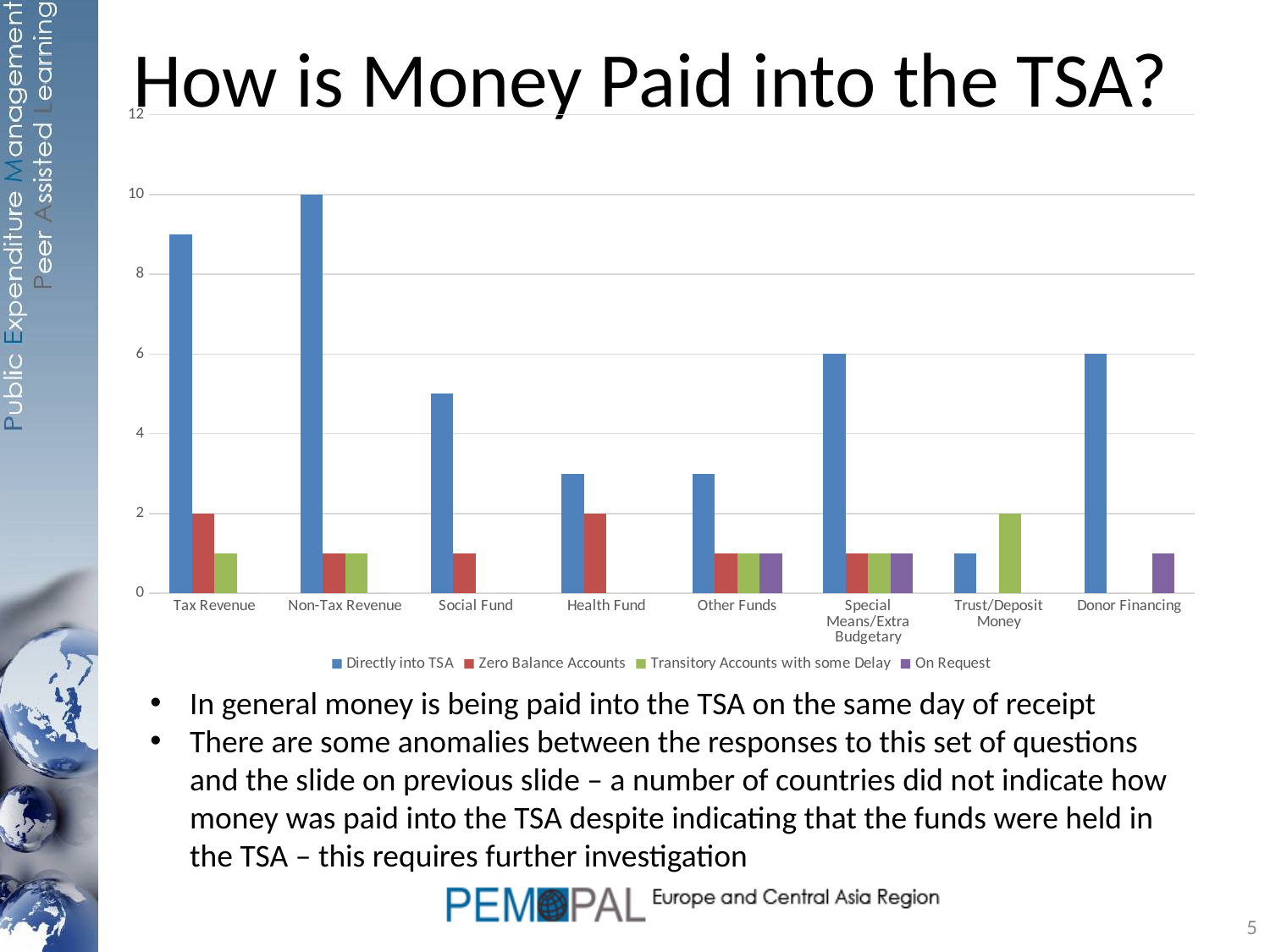
Which category has the highest value for Directly into TSA? Non-Tax Revenue What is the value of Zero Balance Accounts for Health Fund? 2 What is the value of Transitory Accounts with some Delay for Trust/Deposit Money? 2 Which category has the lowest value for Directly into TSA? Trust/Deposit Money Is the value of Directly into TSA for Social Fund greater or less than 4? greater How many categories are shown on the x axis? 8 What is the value of Directly into TSA for Non-Tax Revenue? 10 What is the value of Directly into TSA for Donor Financing? 6 Which is larger for Directly into TSA: Health Fund or Special Means/Extra Budgetary? Special Means/Extra Budgetary Is the value of Directly into TSA for Tax Revenue greater or less than 8? greater How many series does the legend list? 4 What type of chart is shown on the slide? bar chart